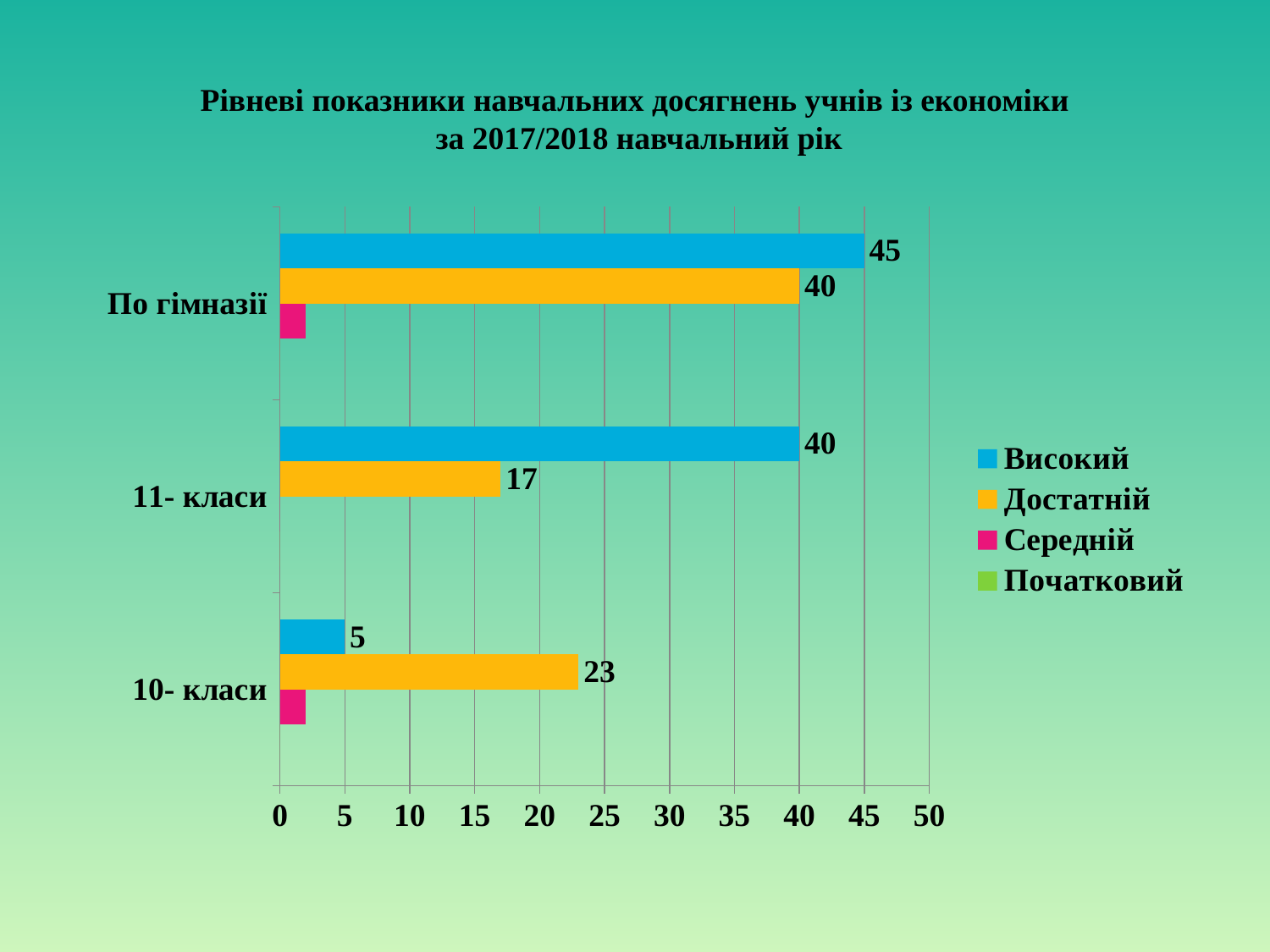
What kind of chart is shown on the slide? bar chart What is the value of Високий for По гімназії? 45 What is the value of Високий for 10- класи? 5 What is the value of Достатній for 10- класи? 23 How many series does the legend list? 4 Which category has the lowest Достатній value? 11- класи Is the Середній value for По гімназії greater or less than 5? less Which is larger for 10- класи: Високий or Достатній? Достатній What is the value of Достатній for 11- класи? 17 How many categories are shown on the vertical axis? 3 Which category has the highest Високий value? По гімназії What is the difference between the Високий values for По гімназії and 11- класи? 5